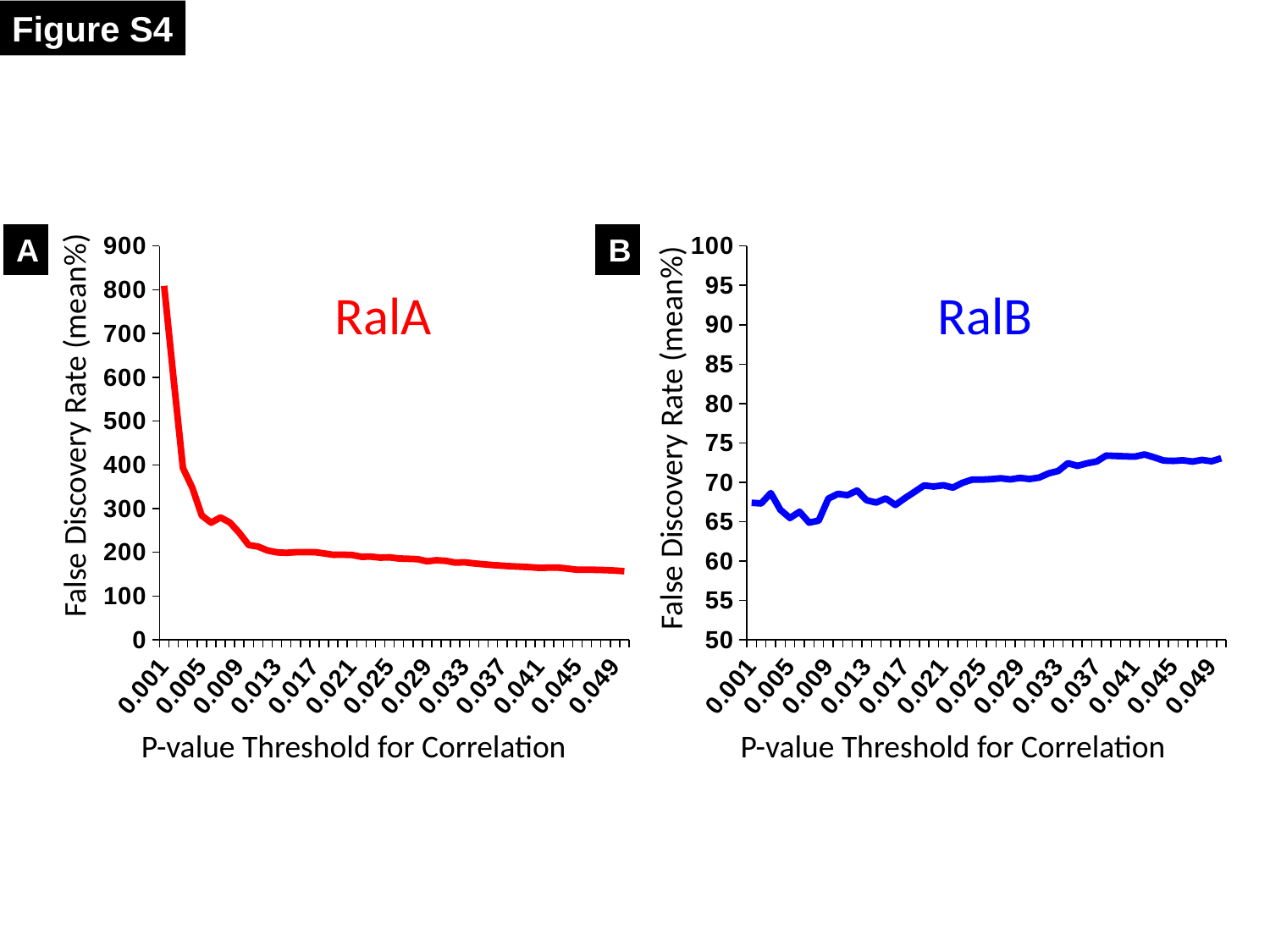
In chart A (RalA), is the False Discovery Rate at a P-value threshold of 0.013 greater or less than 300? less In chart A (RalA), do the values rise or fall as the P-value threshold increases along the x axis? fall What colour is the line in chart B (RalB)? blue In chart B (RalB), is the False Discovery Rate at a P-value threshold of 0.049 greater or less than 70? greater In chart B (RalB), is the False Discovery Rate at a P-value threshold of 0.009 greater or less than 70? less What kind of chart is chart B (RalB)? line chart What kind of chart is chart A (RalA)? line chart In chart B (RalB), do the values rise or fall overall as the P-value threshold increases along the x axis? rise What is the x-axis label of chart A (RalA)? P-value Threshold for Correlation